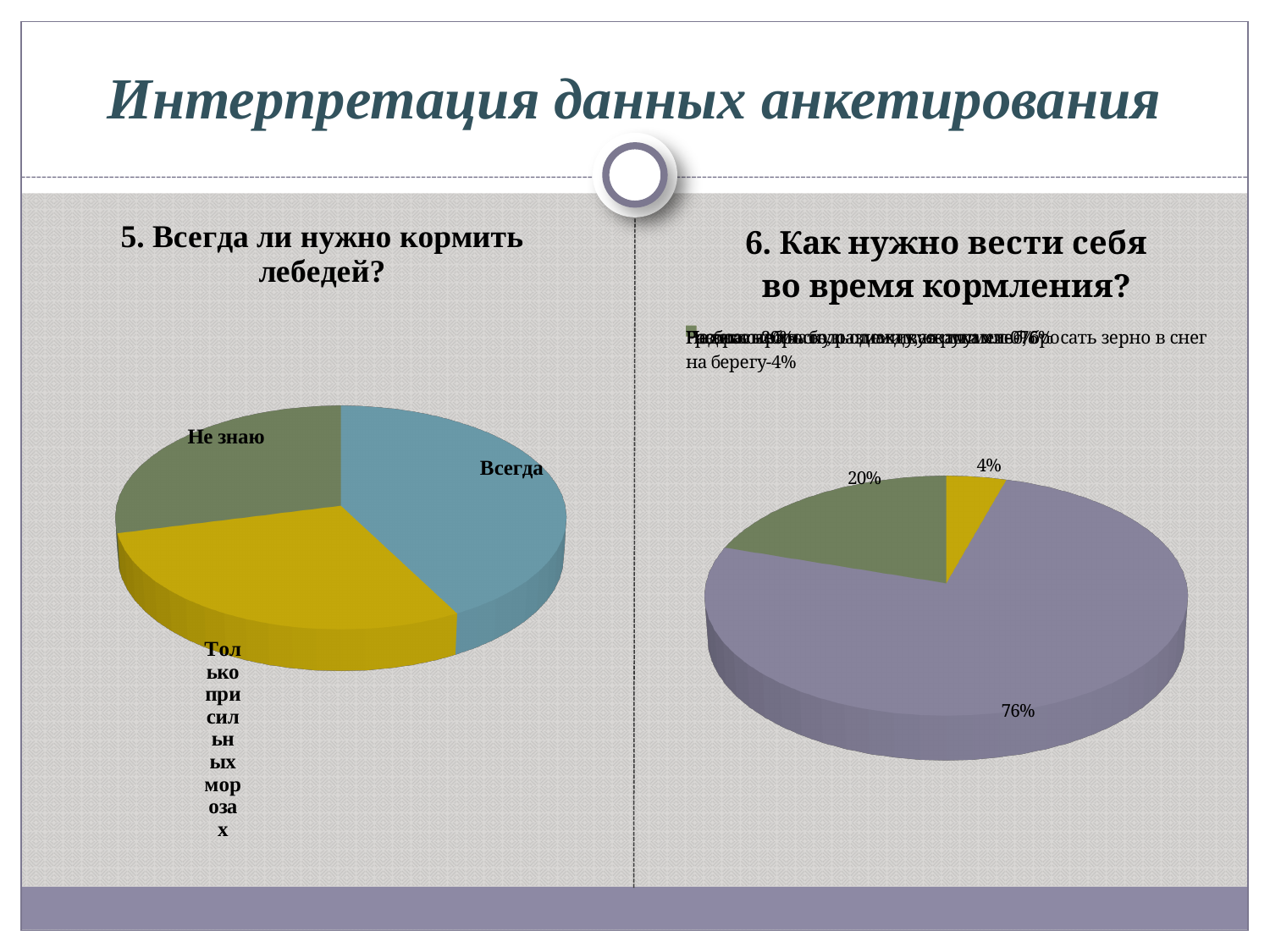
In the pie chart "5. Всегда ли нужно кормить лебедей?", what colour is the "Всегда" slice? blue In the pie chart "6. Как нужно вести себя во время кормления?", what is the smallest slice's value? 4% In the pie chart "6. Как нужно вести себя во время кормления?", what colour is the 76% slice? purple In the pie chart "5. Всегда ли нужно кормить лебедей?", which slice is larger: "Всегда" or "Не знаю"? Всегда In the pie chart "6. Как нужно вести себя во время кормления?", what is the value of the green slice? 20% In the pie chart "6. Как нужно вести себя во время кормления?", what is the difference between the largest slice (76%) and the 20% slice? 56% How many slices does the pie chart "5. Всегда ли нужно кормить лебедей?" have? 3 How many slices does the pie chart "6. Как нужно вести себя во время кормления?" have? 3 In the pie chart "6. Как нужно вести себя во время кормления?", what is the largest slice's value? 76% What kind of chart is shown under the title "6. Как нужно вести себя во время кормления?"? pie chart What kind of chart is shown under the title "5. Всегда ли нужно кормить лебедей?"? pie chart